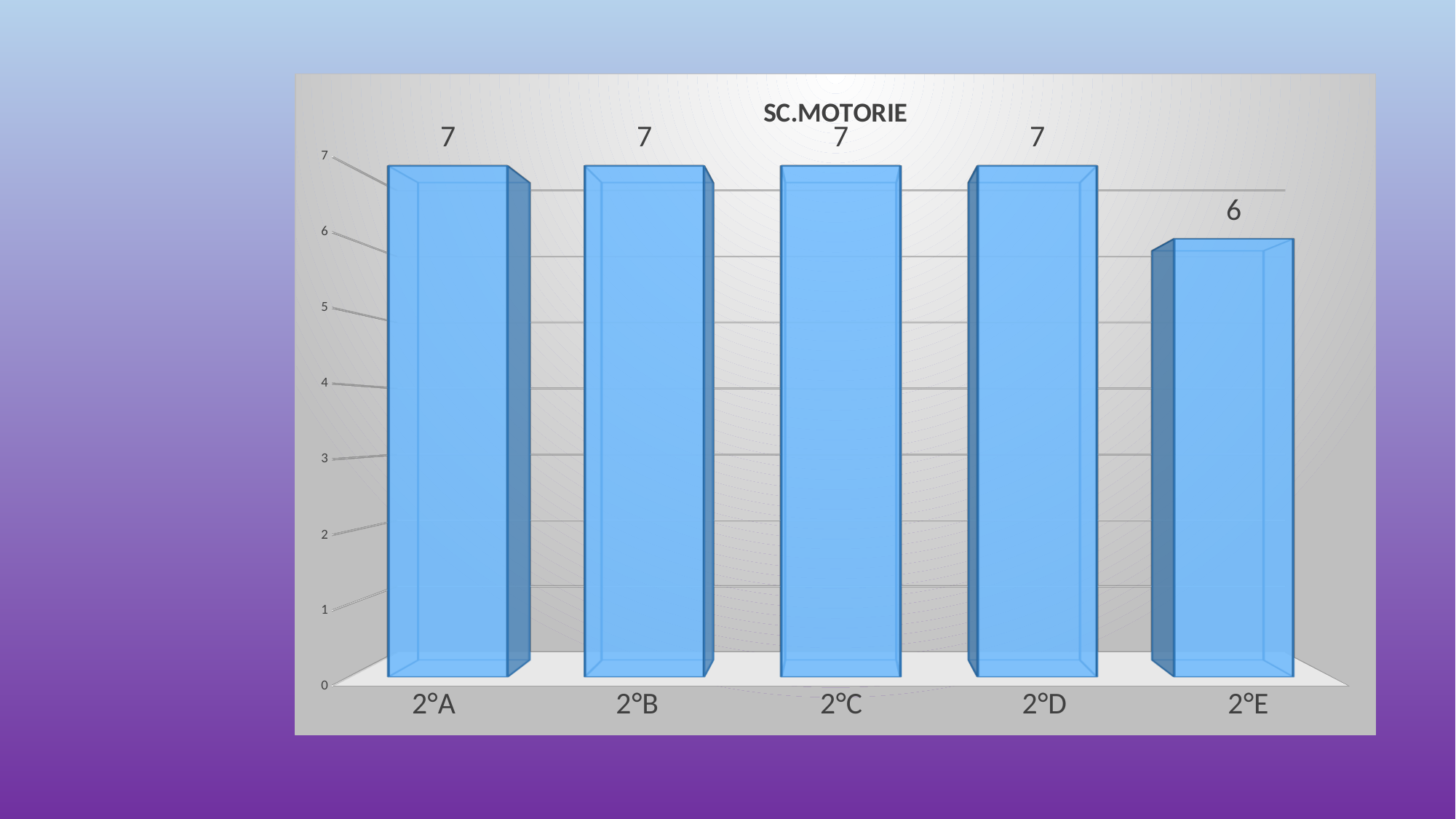
What is the highest value shown on the vertical axis? 7 What is the difference between the values for 2°D and 2°E? 1 What kind of chart is shown? bar chart How many categories are shown on the x axis? 5 What is the value for 2°E? 6 Which category has the lowest value? 2°E What is the value for 2°A? 7 How many categories have a value of 7? 4 What is the title of the chart? SC.MOTORIE Which is larger, the value for 2°B or the value for 2°E? 2°B What is the value for 2°C? 7 Is the value for 2°E greater or less than 5? greater